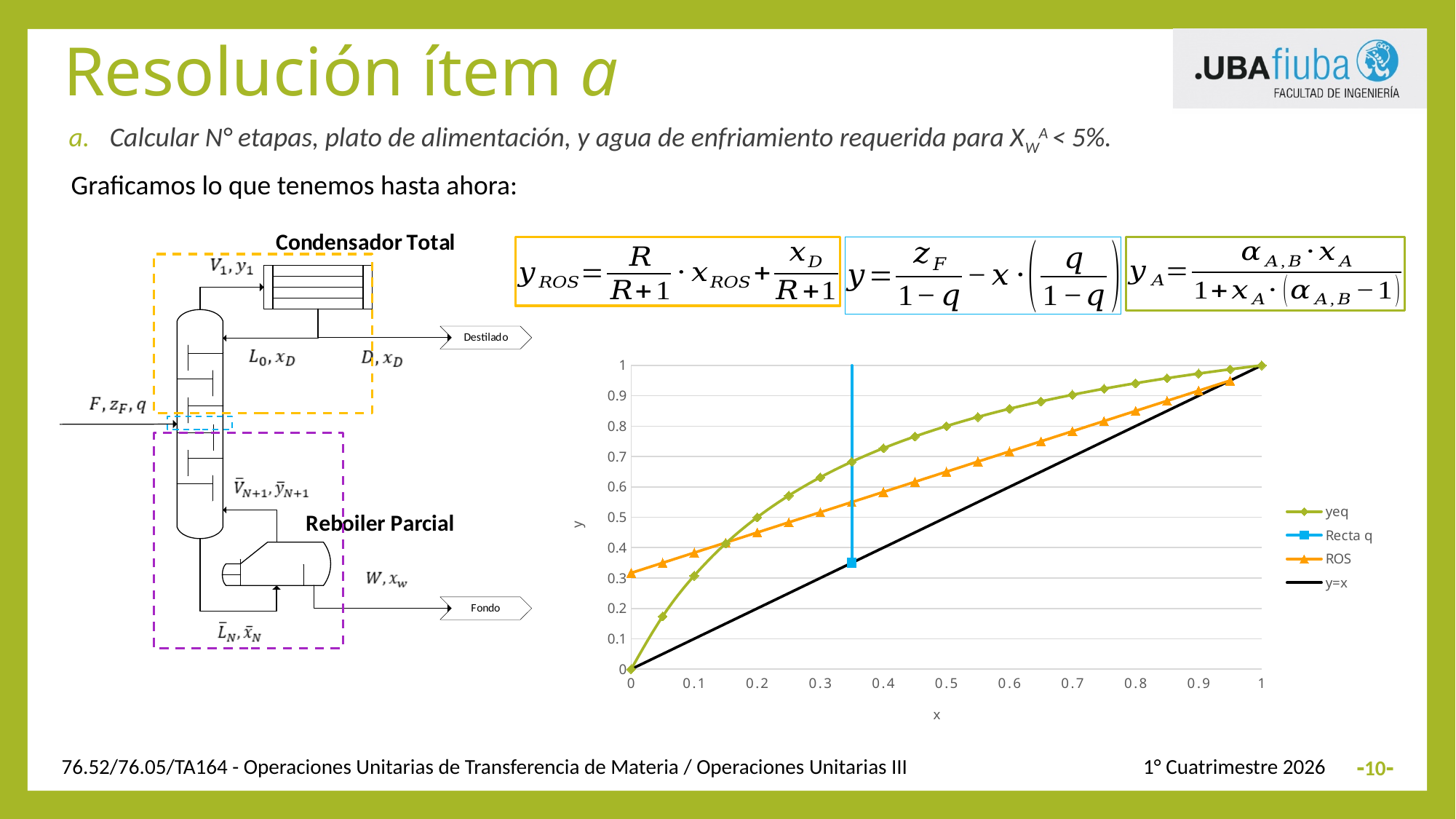
What are the four series named in the chart legend? yeq, Recta q, ROS, y=x Is the value of the yeq series at x = 0.5 greater or less than 0.7? greater At x = 0.5, which series has the larger value, yeq or ROS? yeq How many series does the chart legend list? 4 What is the value of the yeq series at x = 1? 1 Is the value of the ROS series at x = 0 greater or less than 0.2? greater At x = 0.1, which series has the larger value, yeq or ROS? ROS What is the value of the yeq series at x = 0? 0 What is the label of the horizontal axis of the chart? x Is the value of the ROS series at x = 0.5 greater or less than 0.6? greater What kind of chart is shown on the slide? line chart Does the yeq series rise or fall as x increases? rise